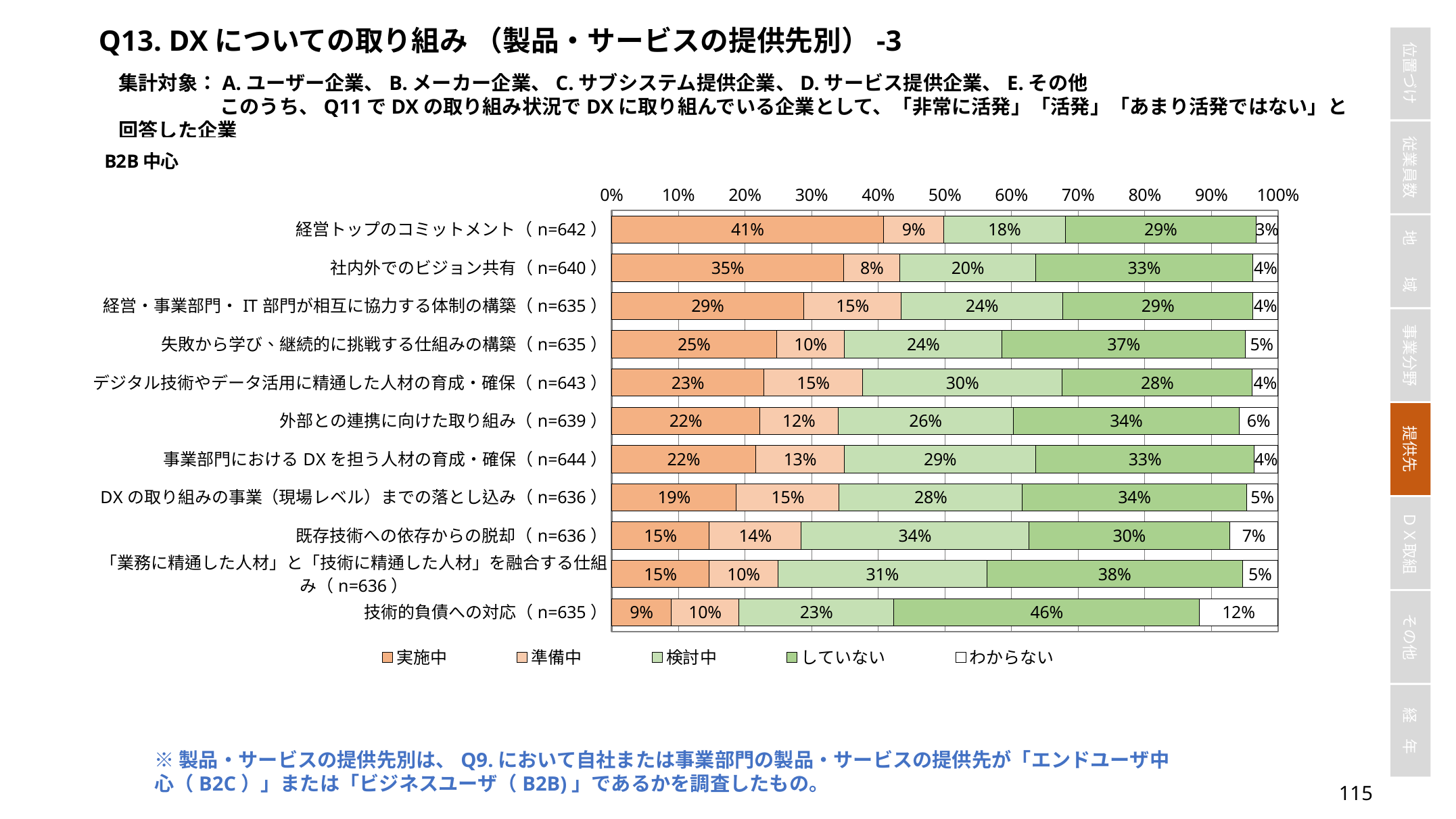
How many series does the legend list? 5 What is the 実施中 value for 経営トップのコミットメント? 41% What kind of chart is shown on the slide? Stacked bar chart Which category has the highest 実施中 value? 経営トップのコミットメント What is the わからない value for 技術的負債への対応? 12% What is the していない value for 技術的負債への対応? 46% Which category has the highest していない value? 技術的負債への対応 What is the 検討中 value for 既存技術への依存からの脱却? 34% How many categories (bars) are shown in the chart? 11 What is the difference between the 実施中 values for 経営トップのコミットメント and 社内外でのビジョン共有? 6% Which is larger: the 検討中 value for デジタル技術やデータ活用に精通した人材の育成・確保 or the 検討中 value for 外部との連携に向けた取り組み? デジタル技術やデータ活用に精通した人材の育成・確保 Which category has the lowest 実施中 value? 技術的負債への対応